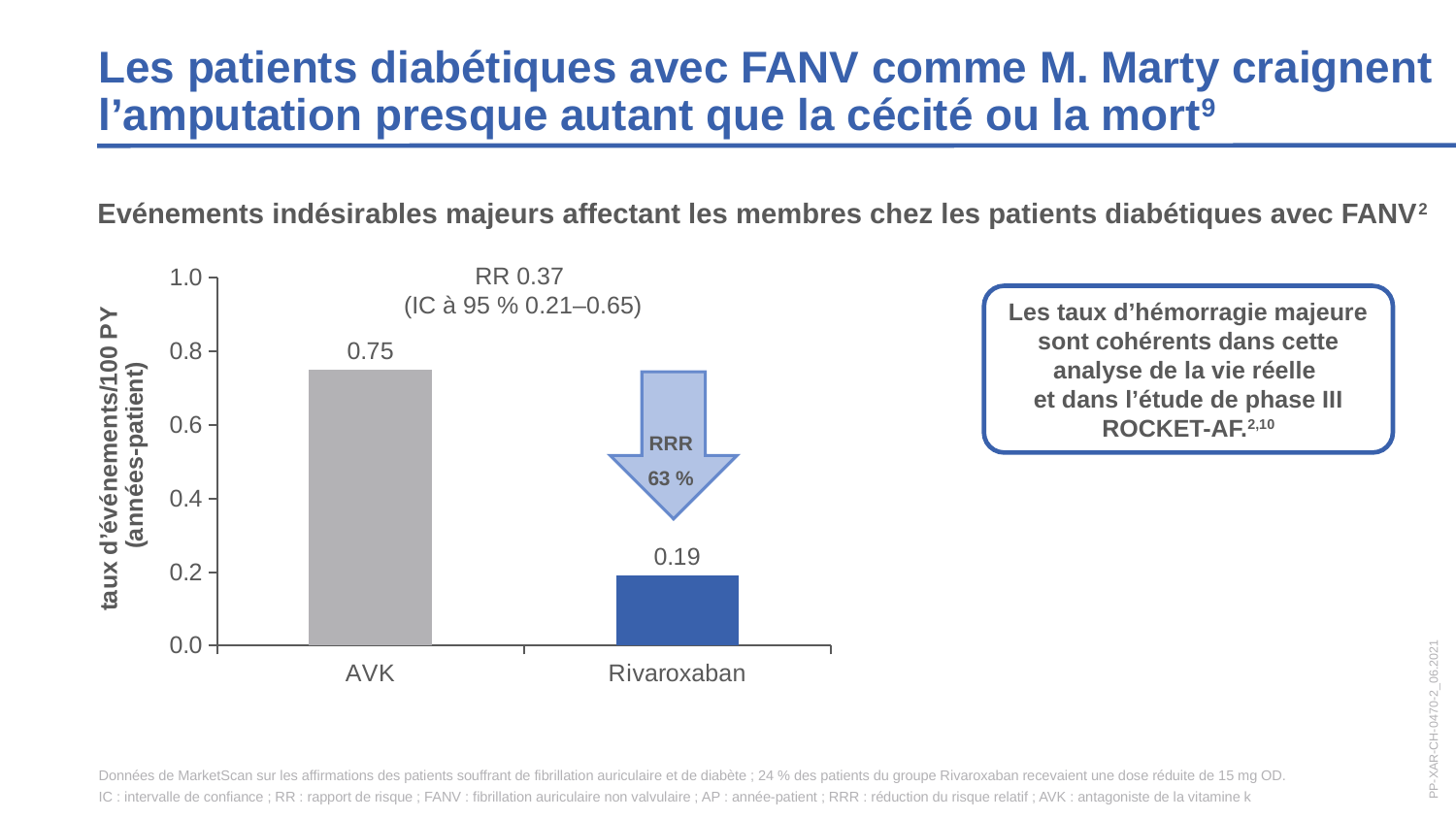
What is the RR value shown above the bars? 0.37 What is the difference between the AVK and Rivaroxaban event rates? 0.56 Is the value for Rivaroxaban greater or less than 0.4? less What is the relative risk reduction (RRR) shown on the chart? 63 % What is the event rate for AVK? 0.75 What is the label of the y axis? taux d'événements/100 PY (années-patient) Which category has the lower event rate? Rivaroxaban Which category has the higher event rate? AVK Is the value for AVK greater or less than 0.6? greater What is the event rate for Rivaroxaban? 0.19 What kind of chart is shown? bar chart How many categories are shown on the x axis? 2